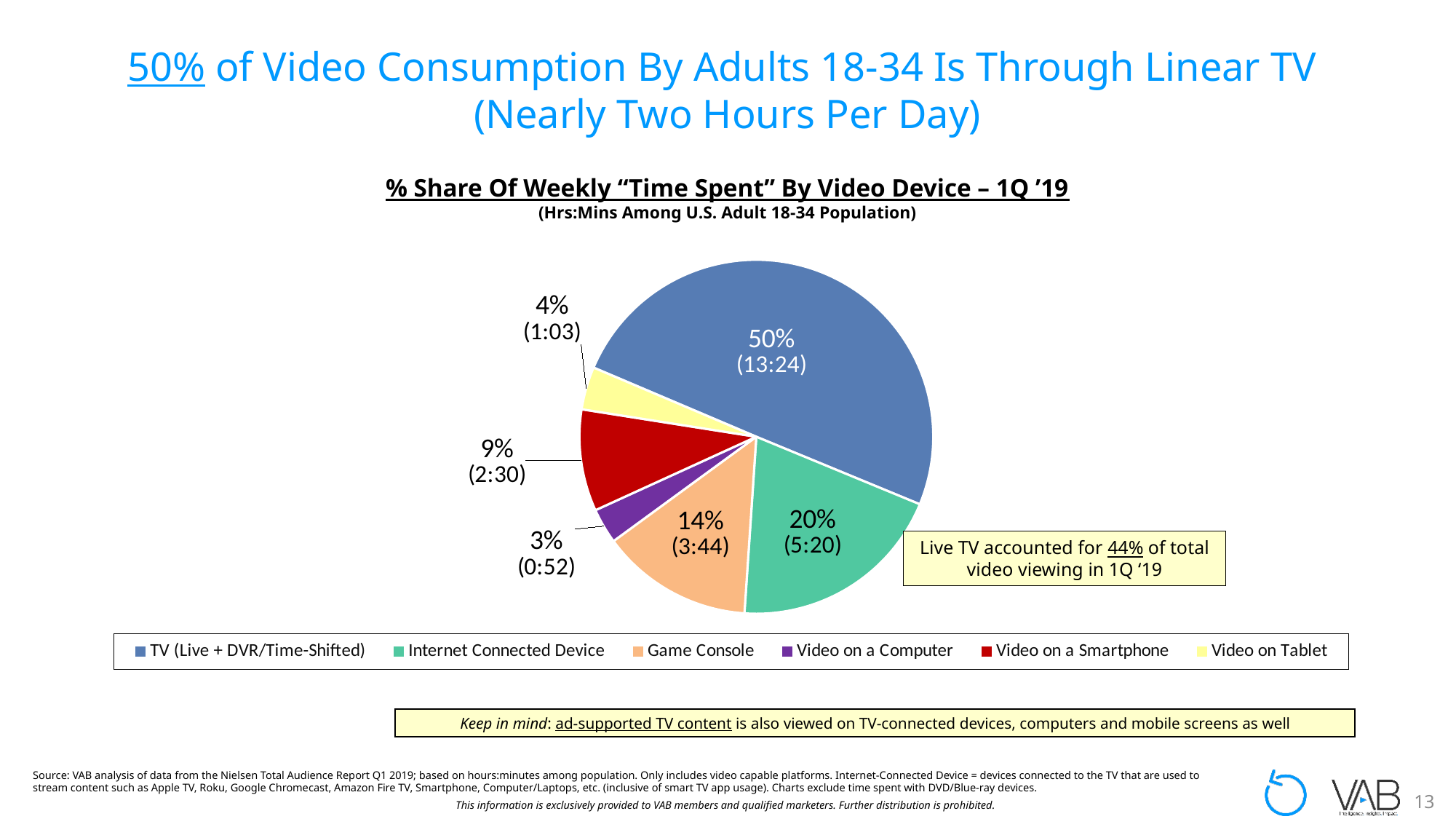
What colour is the Game Console slice? Orange What share of weekly time spent does Video on Tablet account for? 4% How many hours and minutes per week are spent on Video on a Smartphone? 2:30 Which device has the largest share of weekly time spent? TV (Live + DVR/Time-Shifted) What share of weekly time spent does TV (Live + DVR/Time-Shifted) account for? 50% How many hours and minutes per week are spent on Internet Connected Device? 5:20 Which device has the smallest share of weekly time spent? Video on a Computer What type of chart is shown on the slide? Pie chart How many device categories does the legend list? 6 What is the difference in percentage points between the Internet Connected Device share and the Game Console share? 6 What share of weekly time spent does Game Console account for? 14% Which has a larger share: Video on a Smartphone or Video on Tablet? Video on a Smartphone